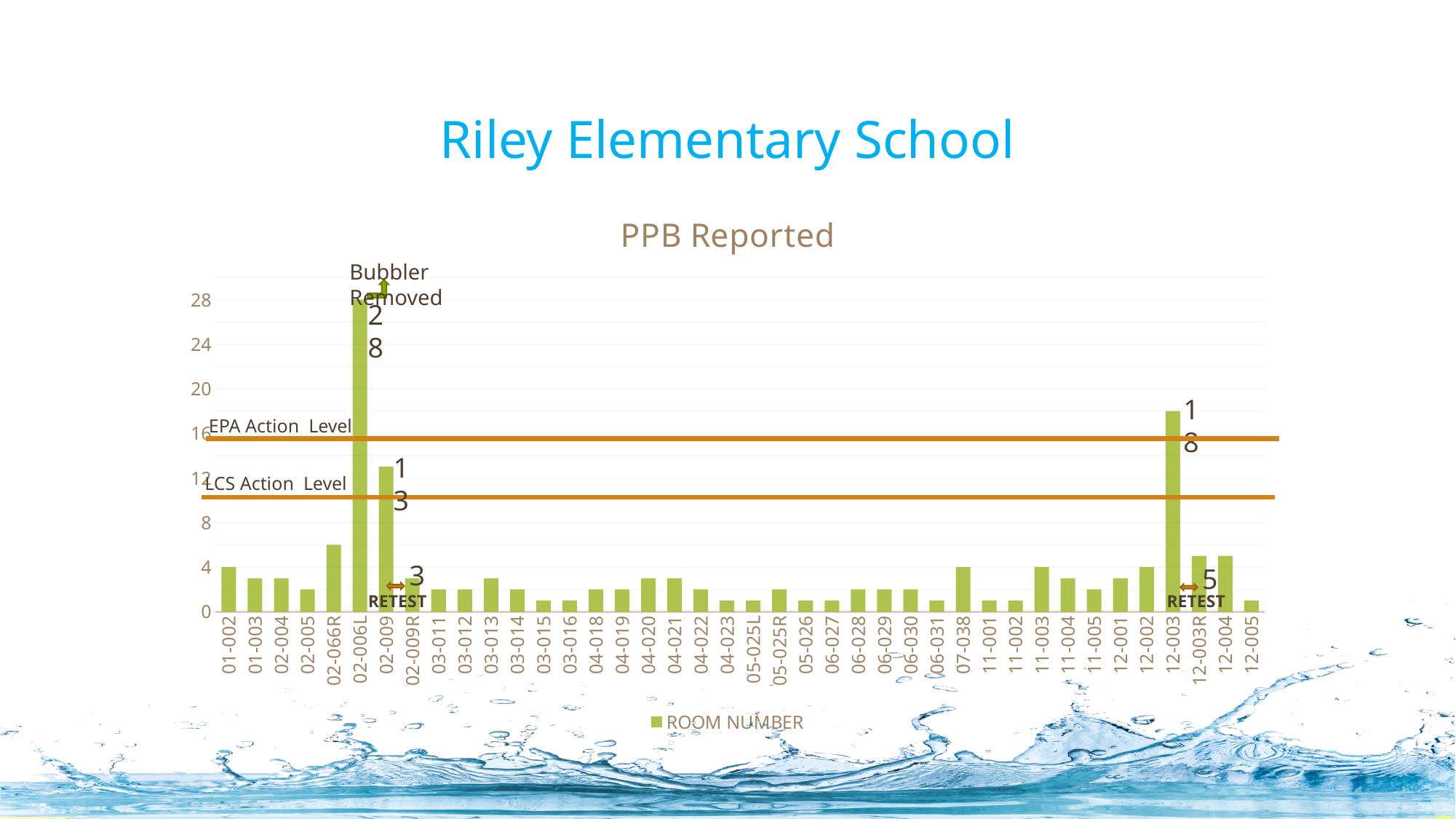
Which room has the larger value, 02-009 or 12-003? 12-003 In the PPB Reported chart, what value is shown for room 12-003? 18 Is the value for room 02-066R greater or less than 4? greater What is the difference between the values for rooms 02-006L and 12-003? 10 In the PPB Reported chart, what value is shown for room 02-006L? 28 In the PPB Reported chart, what value is shown for room 12-003R? 5 Which room has the highest PPB reported value? 02-006L What kind of chart is the PPB Reported chart? bar chart In the PPB Reported chart, what value is shown for the retest of room 02-009R? 3 How many room numbers are plotted on the x axis of the PPB Reported chart? 40 In the PPB Reported chart, what value is shown for room 02-009? 13 How many series does the legend of the PPB Reported chart list? 1